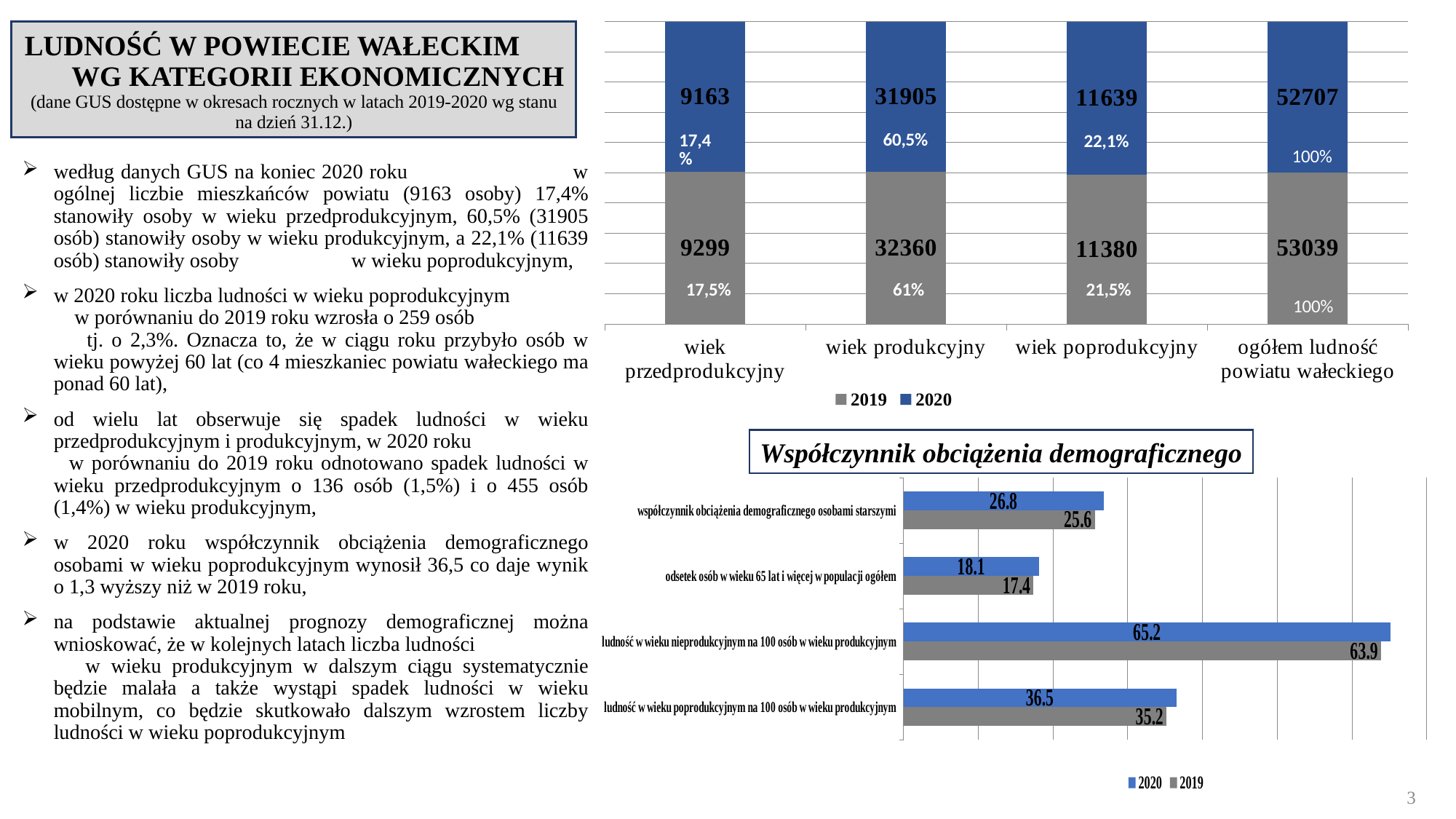
In the chart titled 'Współczynnik obciążenia demograficznego', what is the 2019 value for odsetek osób w wieku 65 lat i więcej w populacji ogółem? 17.4 In the chart titled 'Współczynnik obciążenia demograficznego', which category has the highest 2020 value? ludność w wieku nieprodukcyjnym na 100 osób w wieku produkcyjnym In the top-right stacked bar chart, what percentage label is shown for the 2020 segment of wiek przedprodukcyjny? 17,4% In the top-right stacked bar chart, what is the difference between the 2019 and 2020 values for ogółem ludność powiatu wałeckiego? 332 In the top-right stacked bar chart, which is larger for wiek poprodukcyjny: the 2019 value or the 2020 value? 2020 In the top-right stacked bar chart, what is the 2020 value for wiek produkcyjny? 31905 In the top-right stacked bar chart, what is the 2019 value for wiek poprodukcyjny? 11380 In the top-right stacked bar chart, how many categories are shown on the x axis? 4 In the chart titled 'Współczynnik obciążenia demograficznego', what is the difference between the 2020 and 2019 values for ludność w wieku poprodukcyjnym na 100 osób w wieku produkcyjnym? 1.3 What kind of chart is the one titled 'Współczynnik obciążenia demograficznego'? bar chart In the top-right stacked bar chart, how many series does the legend list? 2 In the chart titled 'Współczynnik obciążenia demograficznego', what is the 2020 value for ludność w wieku nieprodukcyjnym na 100 osób w wieku produkcyjnym? 65.2